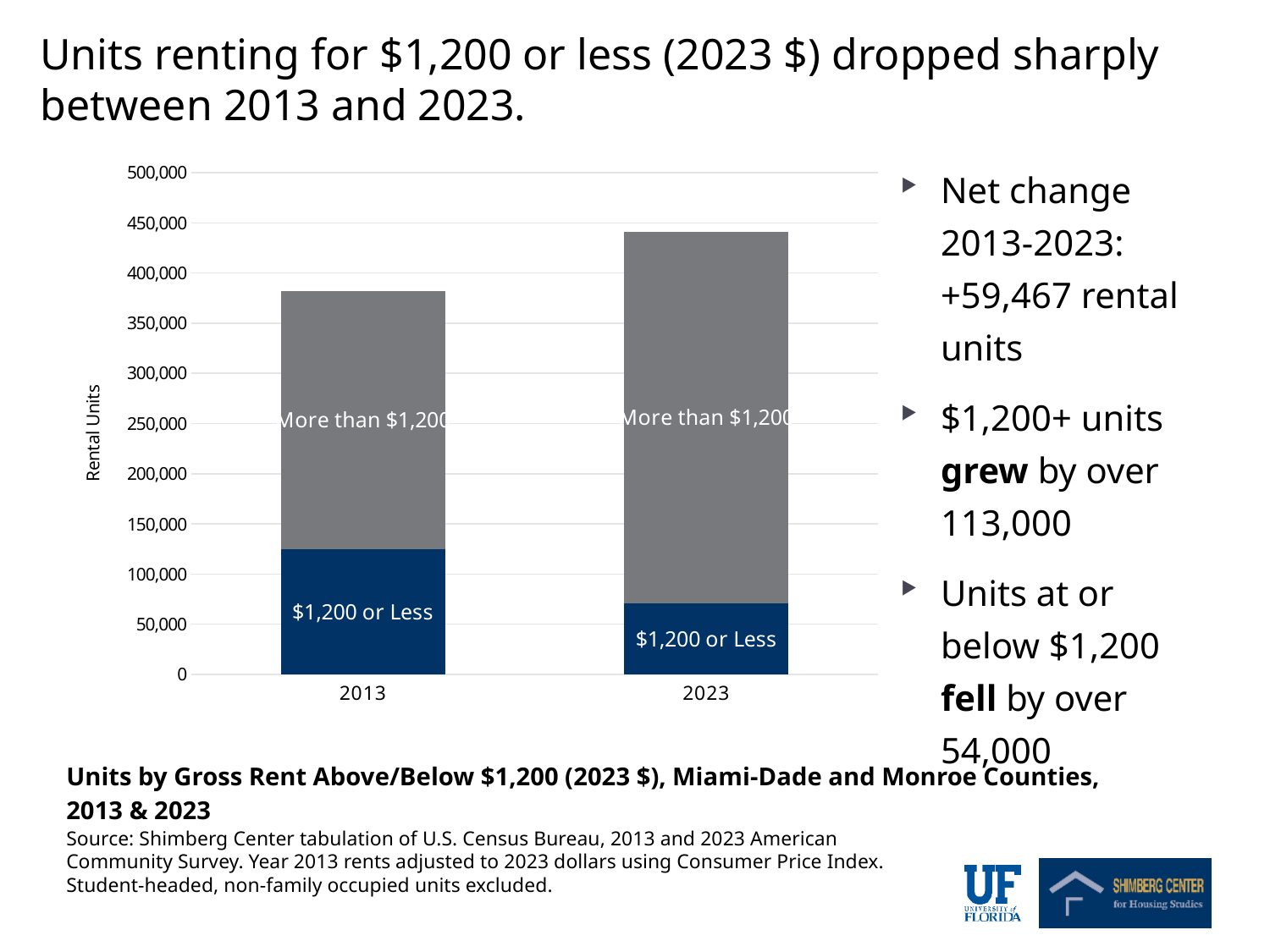
Which year has more '$1,200 or Less' rental units, 2013 or 2023? 2013 How many years (categories) are shown on the x axis of the chart? 2 Which year has the taller total bar, 2013 or 2023? 2023 Does the number of '$1,200 or Less' units rise or fall from 2013 to 2023? fall What is the label on the vertical axis of the chart? Rental Units Is the value for '$1,200 or Less' units in 2013 greater or less than 100,000? greater What kind of chart is shown on the slide? Stacked bar chart How many rent categories (series) are stacked in each bar? 2 Is the total height of the 2023 bar greater or less than 400,000? greater Which segment is shown in dark blue in the chart? $1,200 or Less Is the value for '$1,200 or Less' units in 2023 greater or less than 100,000? less